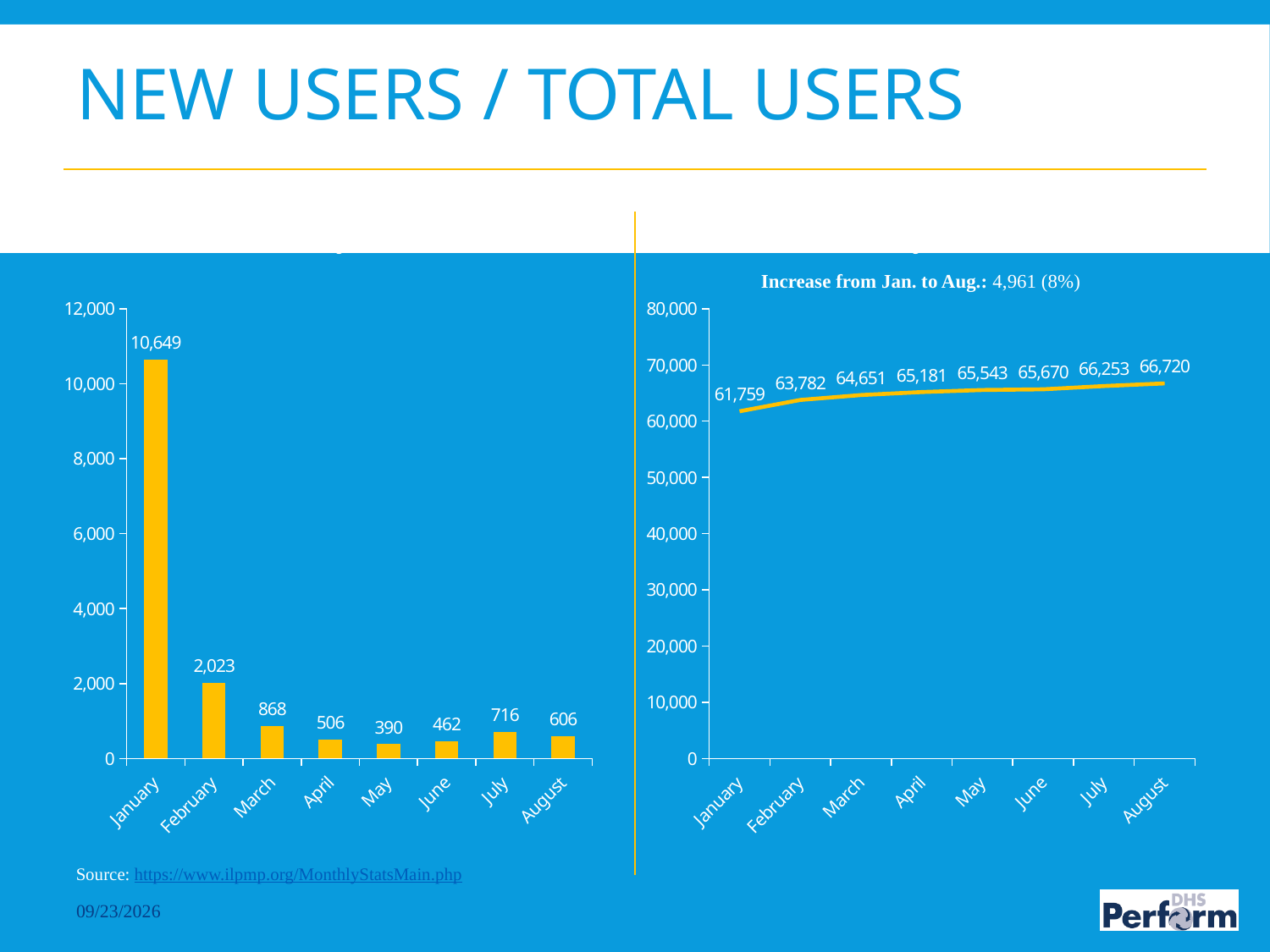
On the right chart, what is the value for March? 64,651 On the left chart, what is the value for January? 10,649 On the right chart, what is the value for August? 66,720 What kind of chart is the chart on the left? Bar chart On the right chart, what is the difference between the values for January and August? 4,961 On the left chart, what is the value for May? 390 On the left chart, what is the difference between the values for February and March? 1,155 On the right chart, do the values rise or fall from January to August? Rise On the left chart, which is larger, the value for July or the value for August? July On the left chart, which month has the lowest value? May How many months are plotted on the right chart? 8 On the left chart, which month has the highest value? January